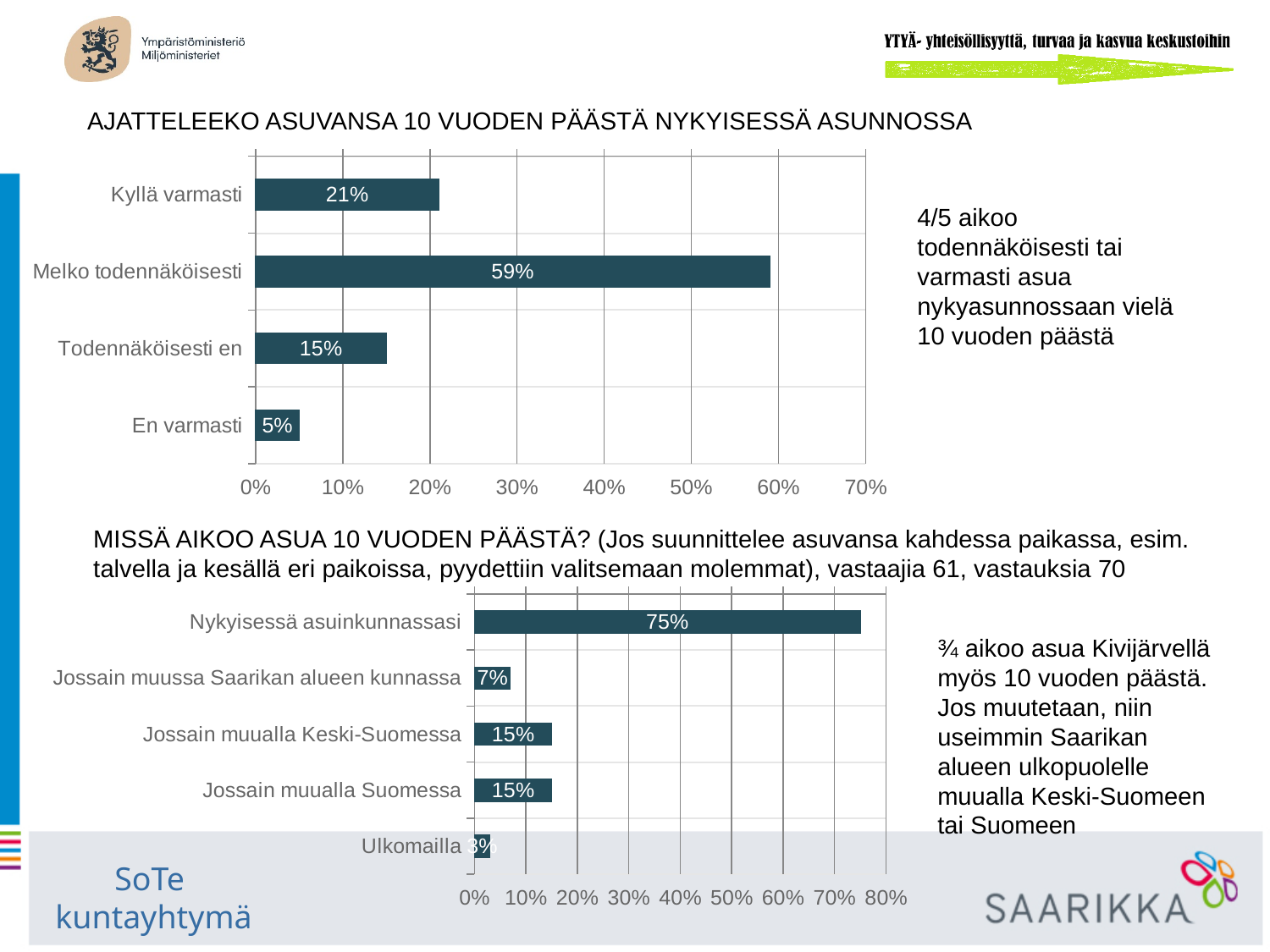
In the top chart, how many categories are shown? 4 In the top chart (AJATTELEEKO ASUVANSA 10 VUODEN PÄÄSTÄ NYKYISESSÄ ASUNNOSSA), what is the value for Melko todennäköisesti? 59% In the bottom chart (MISSÄ AIKOO ASUA 10 VUODEN PÄÄSTÄ?), what is the value for Nykyisessä asuinkunnassasi? 75% In the top chart, what is the value for Kyllä varmasti? 21% In the bottom chart, which is larger: Jossain muussa Saarikan alueen kunnassa or Jossain muualla Keski-Suomessa? Jossain muualla Keski-Suomessa In the top chart, what is the difference between Melko todennäköisesti and Kyllä varmasti? 38% In the top chart, which category has the lowest value? En varmasti In the bottom chart, which category has the highest value? Nykyisessä asuinkunnassasi In the bottom chart, what is the value for Ulkomailla? 3% In the top chart, what is the total of Kyllä varmasti and Melko todennäköisesti? 80% In the bottom chart, how many categories are shown? 5 What type of chart is the bottom chart? Bar chart